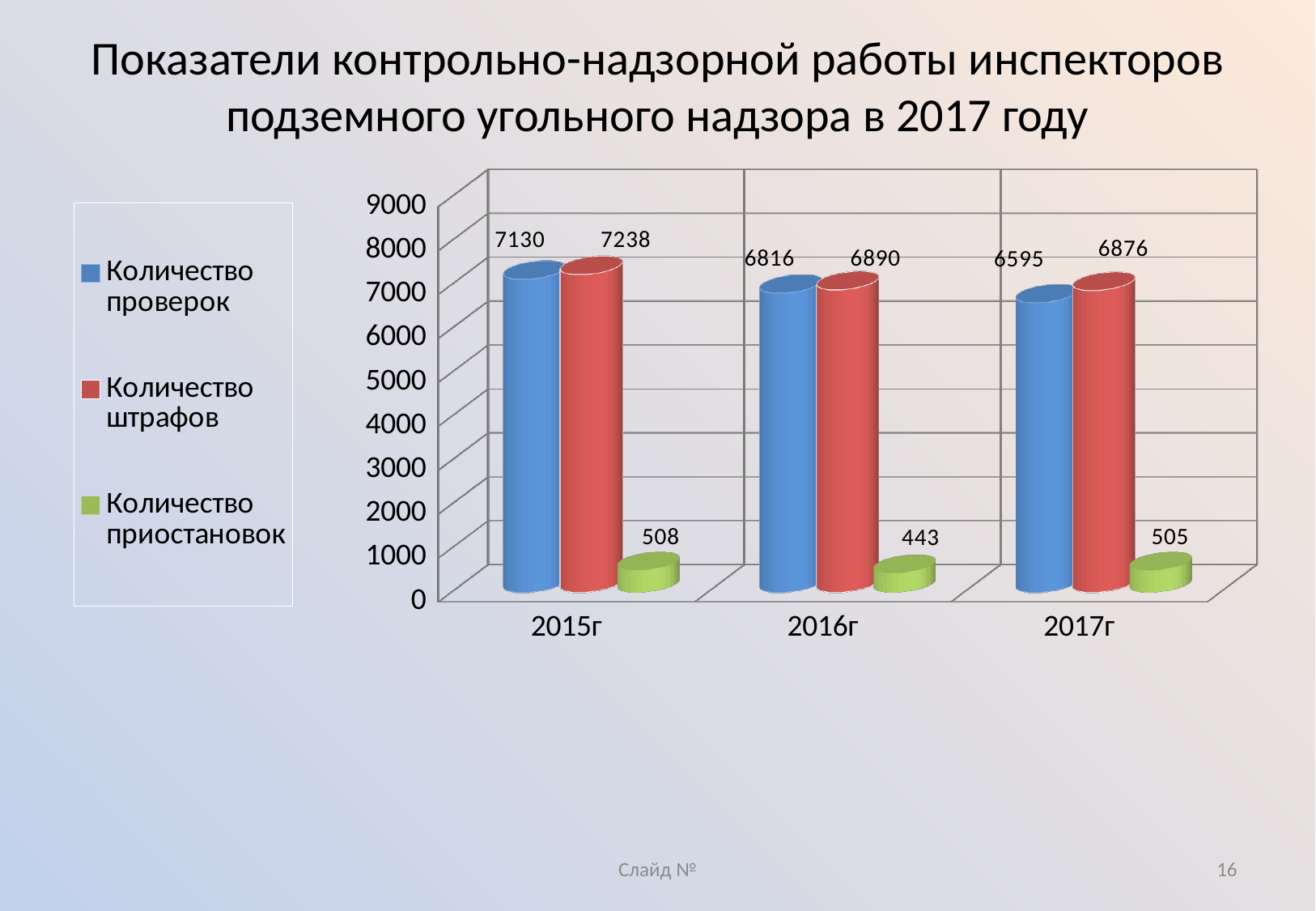
What is the value of Количество штрафов for 2017г? 6876 Is the value of Количество приостановок for 2015г greater or less than 1000? less What is the difference between Количество штрафов and Количество проверок in 2017г? 281 In which year is Количество проверок the highest? 2015г Does Количество проверок rise or fall from 2015г to 2017г? fall In which year is Количество приостановок the lowest? 2016г What is the value of Количество проверок for 2015г? 7130 Which is larger in 2016г: Количество проверок or Количество штрафов? Количество штрафов How many years are shown on the x axis? 3 What kind of chart is shown on the slide? bar chart How many series does the legend list? 3 What is the value of Количество приостановок for 2016г? 443